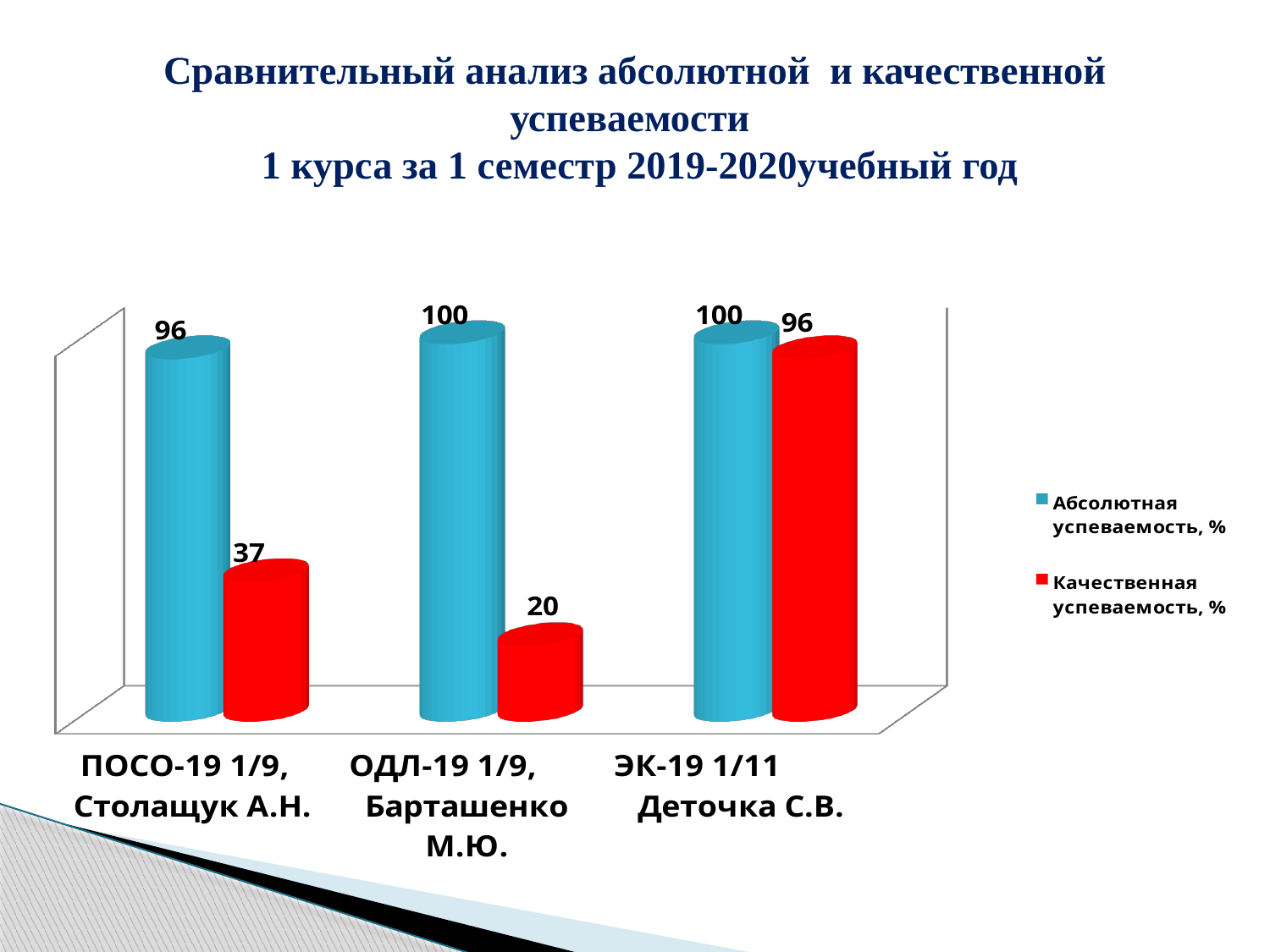
What kind of chart is shown on the slide? Bar chart What is the value of Качественная успеваемость, % for ПОСО-19 1/9, Столащук А.Н.? 37 How many groups (categories) are shown on the chart? 3 What is the value of Качественная успеваемость, % for ЭК-19 1/11 Деточка С.В.? 96 What is the difference in Качественная успеваемость, % between ЭК-19 1/11 Деточка С.В. and ПОСО-19 1/9, Столащук А.Н.? 59 What is the value of Абсолютная успеваемость, % for ПОСО-19 1/9, Столащук А.Н.? 96 Which group has the highest Качественная успеваемость, %? ЭК-19 1/11 Деточка С.В. What is the value of Качественная успеваемость, % for ОДЛ-19 1/9, Барташенко М.Ю.? 20 What is the difference between Абсолютная успеваемость, % and Качественная успеваемость, % for ОДЛ-19 1/9, Барташенко М.Ю.? 80 Which is larger: Качественная успеваемость, % for ПОСО-19 1/9, Столащук А.Н. or for ОДЛ-19 1/9, Барташенко М.Ю.? ПОСО-19 1/9, Столащук А.Н. Which group has the lowest Качественная успеваемость, %? ОДЛ-19 1/9, Барташенко М.Ю. How many series does the legend list? 2